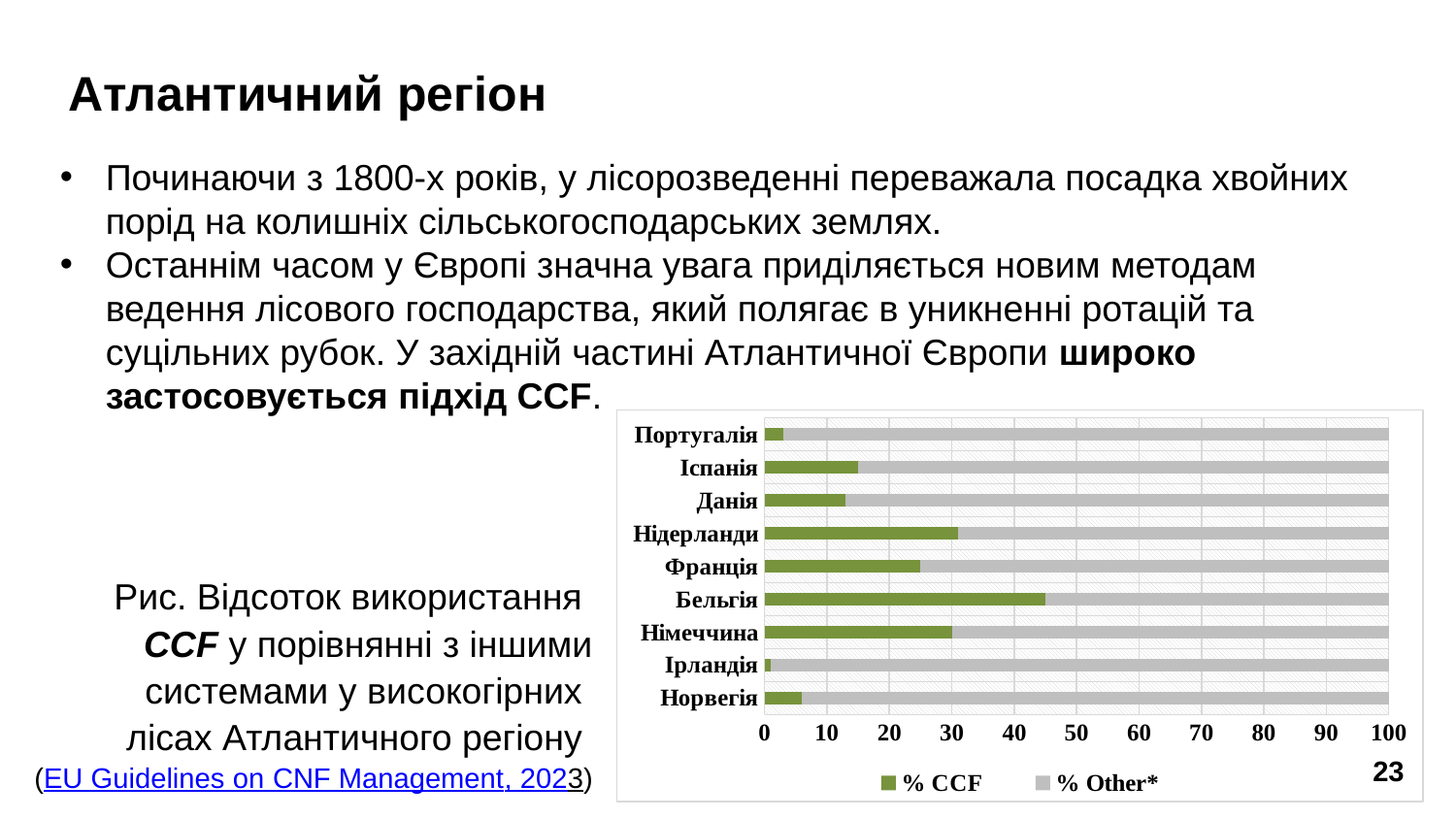
Is the % CCF value for Франція greater or less than 20? greater Is the % CCF value for Іспанія greater or less than 20? less Which has a larger % CCF value, Бельгія or Німеччина? Бельгія How many countries are listed on the chart? 9 Is the % CCF value for Бельгія greater or less than 40? greater How many series does the chart legend list? 2 Which country has the lowest % CCF value? Ірландія What kind of chart is shown on the slide? bar chart What are the two series named in the chart legend? % CCF and % Other* Which country has the highest % CCF value? Бельгія Which has a larger % CCF value, Нідерланди or Франція? Нідерланди